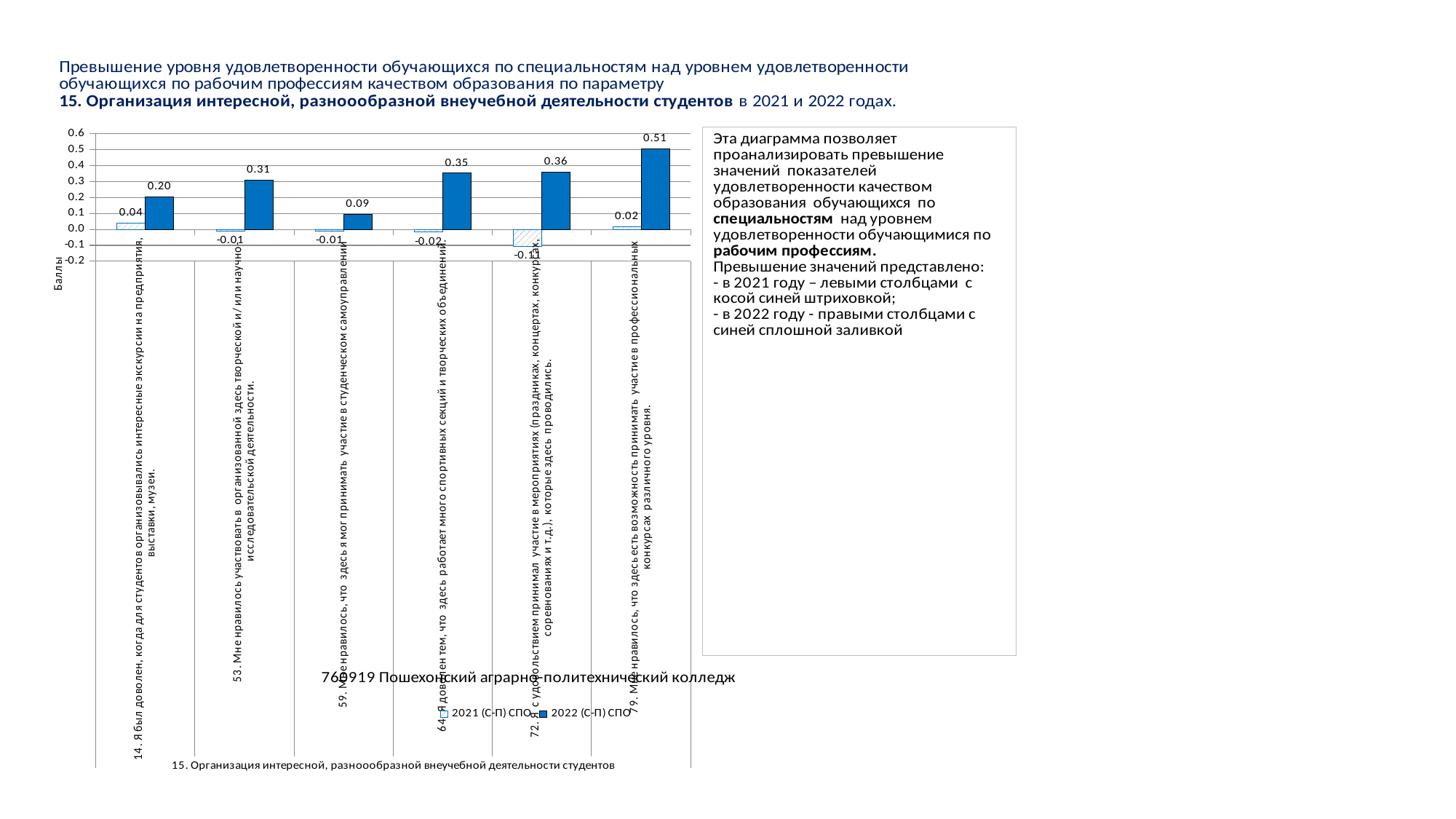
What is the 2022 (С-П) СПО value for item 59 (Мне нравилось, что здесь я мог принимать участие в студенческом самоуправлении)? 0.09 Which is larger for item 64: the 2021 (С-П) СПО value or the 2022 (С-П) СПО value? 2022 (С-П) СПО How many categories are plotted on the x axis of the chart? 6 What is the 2021 (С-П) СПО value for item 14 (Я был доволен, когда для студентов организовывались интересные экскурсии на предприятия, выставки, музеи)? 0.04 What is the difference between the 2022 (С-П) СПО values for item 79 and item 14? 0.31 Which category has the highest 2022 (С-П) СПО value? 79. Мне нравилось, что здесь есть возможность принимать участие в профессиональных конкурсах различного уровня What is the 2022 (С-П) СПО value for item 79 (Мне нравилось, что здесь есть возможность принимать участие в профессиональных конкурсах различного уровня)? 0.51 What kind of chart is shown on the slide? bar chart How many series does the chart legend list? 2 Is the 2022 (С-П) СПО value for item 72 greater or less than 0.3? greater What is the label of the vertical axis of the chart? Баллы Which category has the lowest 2022 (С-П) СПО value? 59. Мне нравилось, что здесь я мог принимать участие в студенческом самоуправлении